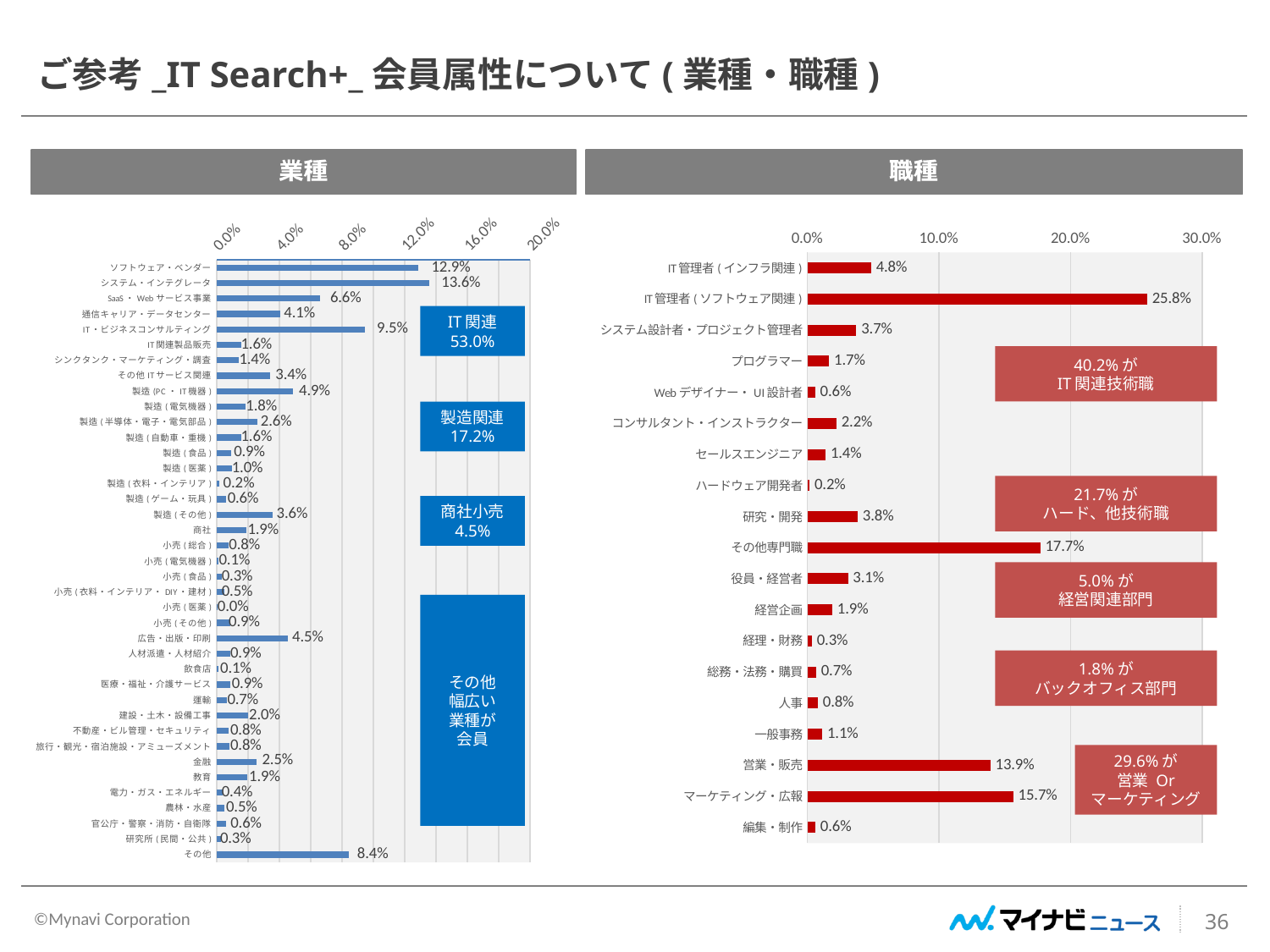
In the 業種 chart, what is the value for IT・ビジネスコンサルティング? 9.5% In the 業種 chart, what is the value for システム・インテグレータ? 13.6% In the 職種 chart, what is the value for IT管理者(ソフトウェア関連)? 25.8% In the 職種 chart, which category has the highest value? IT管理者(ソフトウェア関連) In the 職種 chart, what is the value for 営業・販売? 13.9% In the 職種 chart, is the value for その他専門職 greater or less than 10.0%? greater In the 業種 chart, which is larger, ソフトウェア・ベンダー or SaaS・Webサービス事業? ソフトウェア・ベンダー In the 職種 chart, what is the difference between マーケティング・広報 and 営業・販売? 1.8% In the 業種 chart, which category has the highest value? システム・インテグレータ In the 職種 chart, which category has the lowest value? ハードウェア開発者 What kind of chart is the 職種 chart? Bar chart How many categories are plotted in the 職種 chart? 19